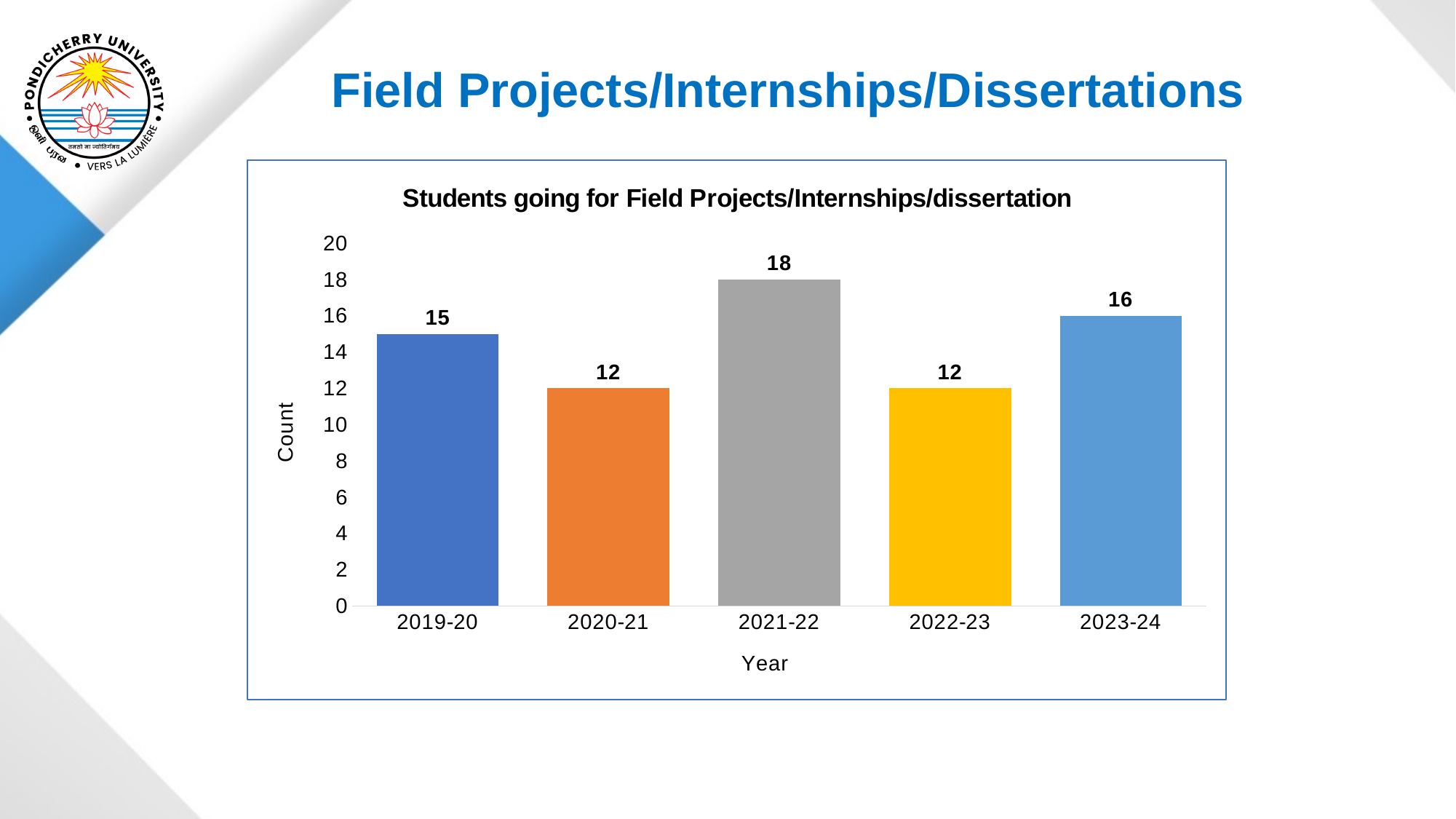
Is the value for 2021-22 greater or less than 16? greater What kind of chart is shown on the slide? Bar chart What is the difference between the counts for 2023-24 and 2019-20? 1 What is the title of the chart? Students going for Field Projects/Internships/dissertation Which year has the highest count of students? 2021-22 What is the difference between the counts for 2021-22 and 2020-21? 6 What is the count of students going for field projects/internships/dissertation in 2019-20? 15 What is the count for 2021-22? 18 How many years are shown on the x axis? 5 What is the count for 2023-24? 16 Which year has a larger count, 2019-20 or 2022-23? 2019-20 Which years share the lowest count of students? 2020-21 and 2022-23